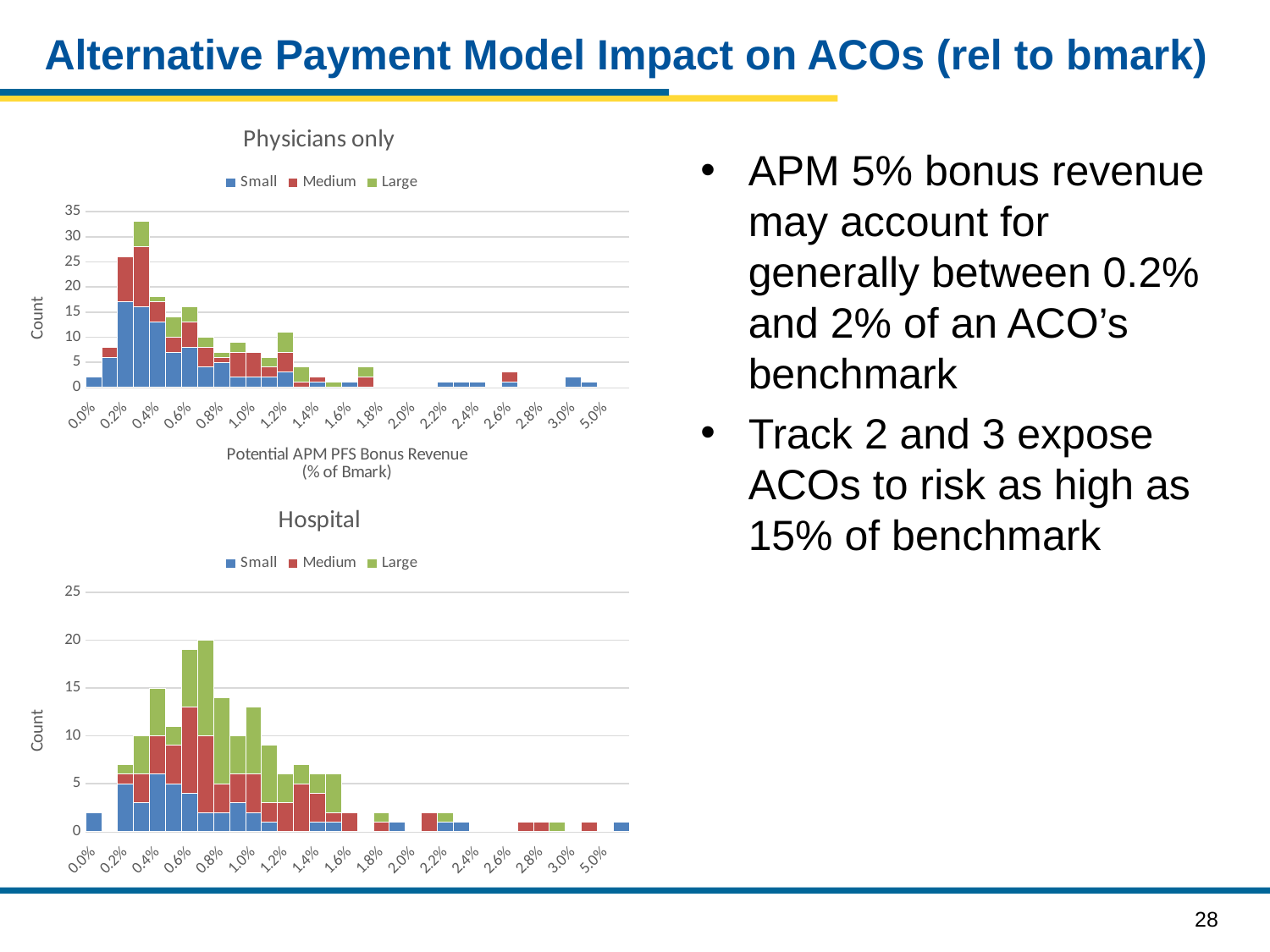
In the "Hospital" chart, is the total count for the 0.2% bar greater or less than 5? greater What is the x-axis title of the "Physicians only" chart? Potential APM PFS Bonus Revenue (% of Bmark) What are the legend entries on the "Physicians only" chart? Small, Medium, Large In the "Physicians only" chart, which bar is taller: 0.2% or 1.0%? 0.2% In the "Physicians only" chart, is the tallest bar greater or less than 30? greater In the "Hospital" chart, which bar is taller: 0.4% or 2.0%? 0.4% What kind of chart is the "Physicians only" chart? Stacked bar chart Which chart has the taller peak bar, "Physicians only" or "Hospital"? Physicians only How many series does the legend of the "Hospital" chart list? 3 In the "Hospital" chart, is the total count for the 0.0% bar greater or less than 5? less